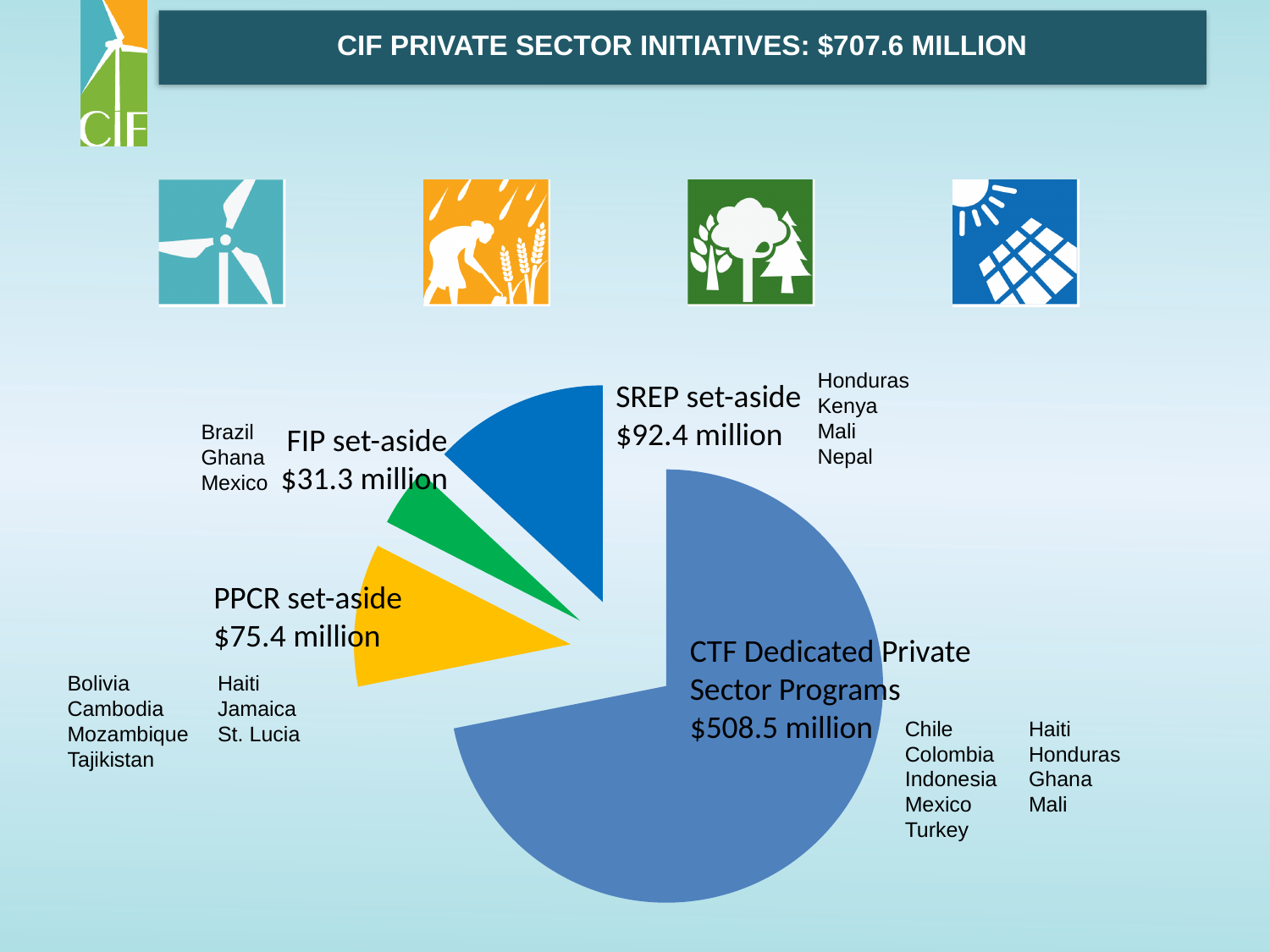
What is the value of the FIP set-aside slice? $31.3 million What is the value of the SREP set-aside slice? $92.4 million Which slice of the pie chart is the smallest? FIP set-aside What is the value of the CTF Dedicated Private Sector Programs slice? $508.5 million What is the value of the PPCR set-aside slice? $75.4 million What is the difference between the PPCR set-aside and the FIP set-aside? $44.1 million What colour is the PPCR set-aside slice? Yellow Which is larger, the SREP set-aside or the PPCR set-aside? SREP set-aside What kind of chart is shown on the slide? Pie chart How many slices does the pie chart have? 4 Which slice of the pie chart is the largest? CTF Dedicated Private Sector Programs What is the difference between the SREP set-aside and the PPCR set-aside? $17.0 million